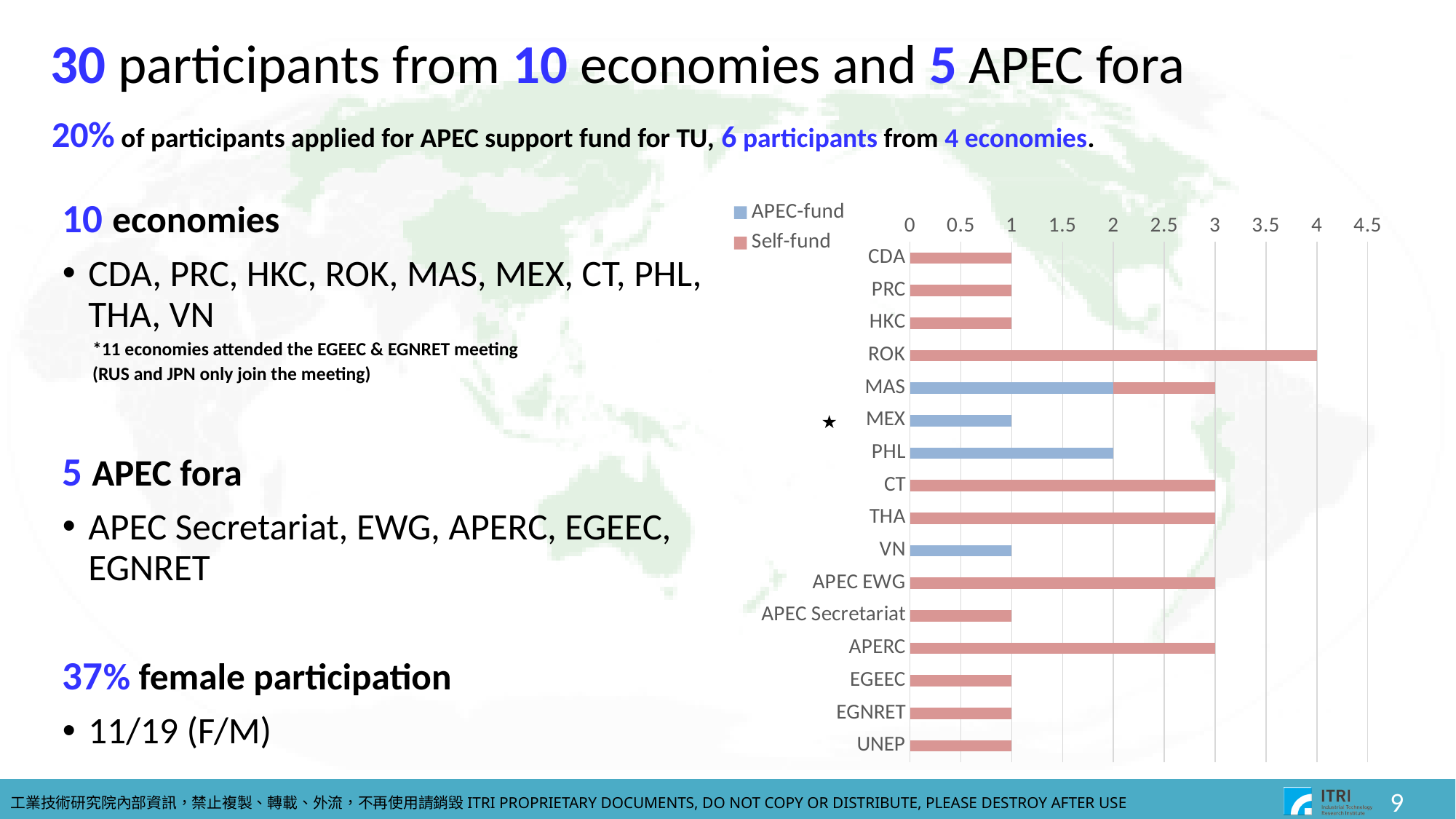
Is the value for APERC greater or less than 2? greater What is the APEC-fund value for MAS? 2 What is the total length of the stacked bar for MAS? 3 What are the two series named in the chart legend? APEC-fund and Self-fund What kind of chart is shown on the slide? bar chart What is the Self-fund value for ROK? 4 Which is larger, the bar for CT or the bar for HKC? CT What is the APEC-fund value for PHL? 2 Which category has the longest bar in the chart? ROK How many series does the chart legend list? 2 How many categories are plotted on the chart? 16 What is the difference between the Self-fund value for ROK and the Self-fund value for CDA? 3